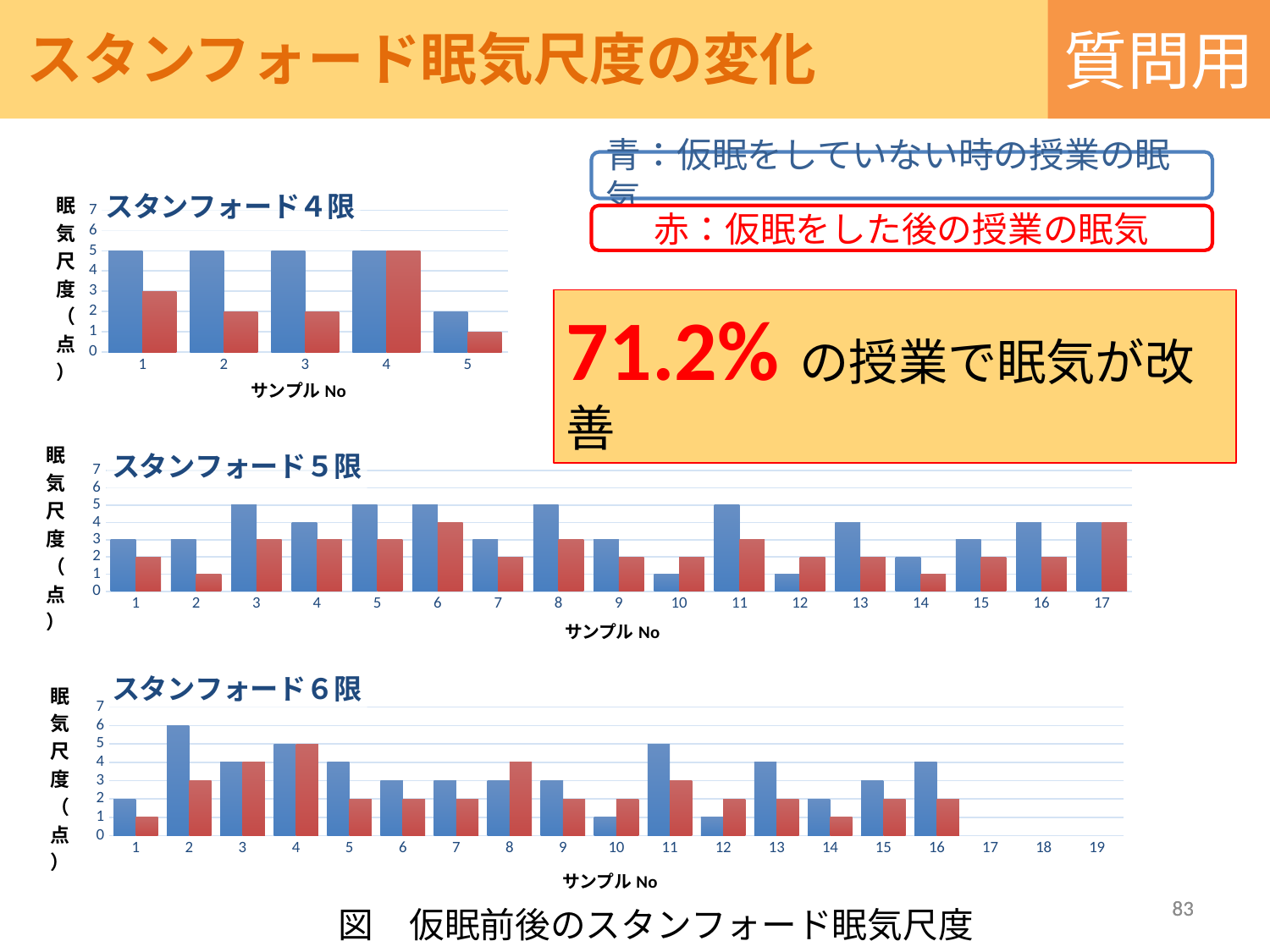
In the スタンフォード6限 chart, which sample has the highest blue bar? 2 In the スタンフォード4限 chart, what is the difference between the blue and red bars for sample 1? 2 In the スタンフォード5限 chart, which is larger for sample 11, the blue bar or the red bar? blue bar In the スタンフォード4限 chart, how many sample numbers are shown on the x axis? 5 What is the title of the bottom chart on the slide? スタンフォード6限 In the スタンフォード4限 chart, what is the value of the red bar for sample 5? 1 In the スタンフォード6限 chart, what is the value of the red bar for sample 4? 5 In the スタンフォード5限 chart, how many sample numbers are shown on the x axis? 17 In the スタンフォード4限 chart, what is the value of the blue bar for sample 1? 5 What kind of chart is スタンフォード4限? bar chart In the スタンフォード6限 chart, what is the value of the blue bar for sample 2? 6 In the スタンフォード5限 chart, what is the value of the red bar for sample 6? 4